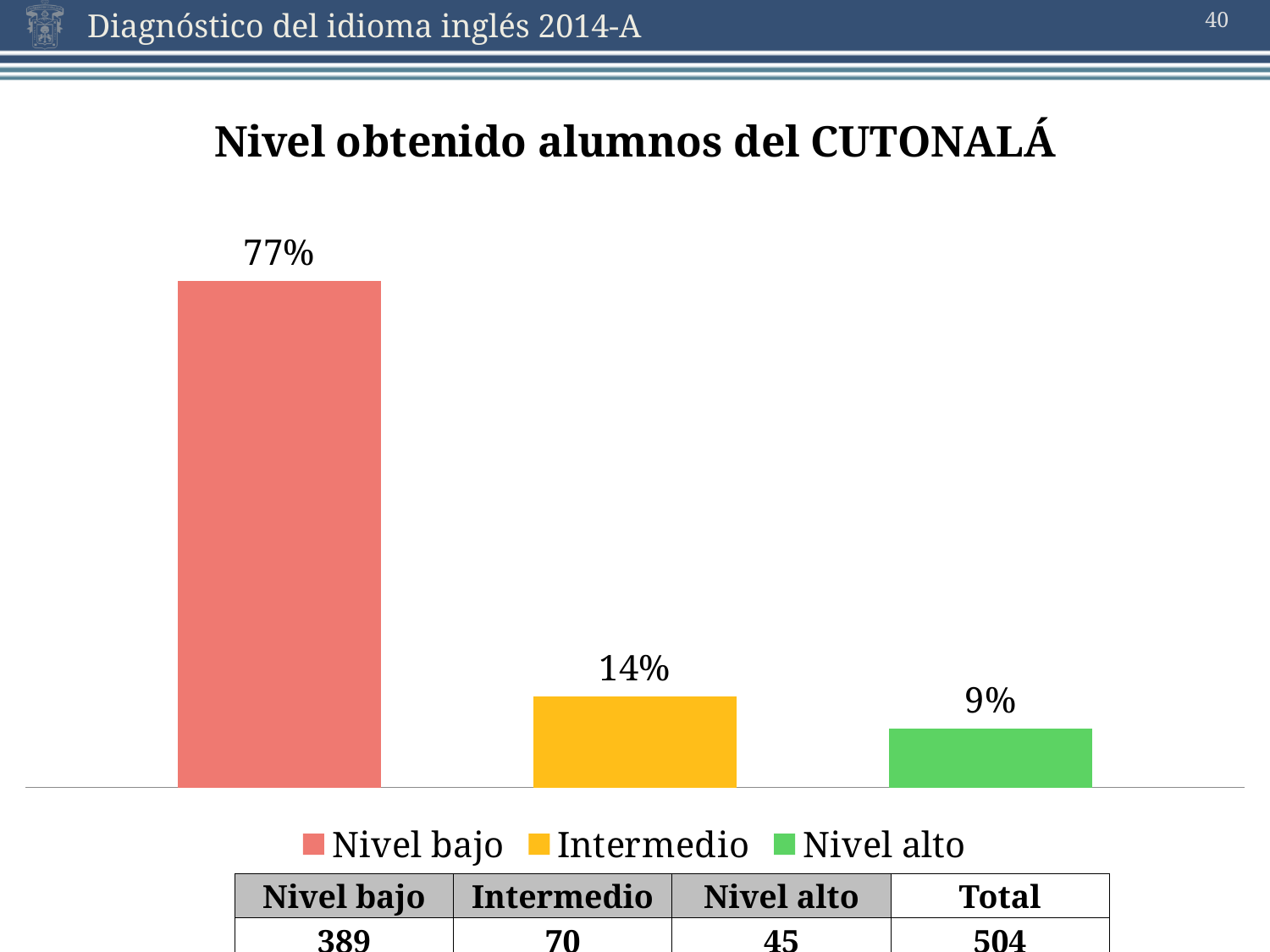
What kind of chart is shown on the slide? Bar chart Which level has the highest percentage? Nivel bajo Which is larger, the percentage for Intermedio or for Nivel alto? Intermedio What is the title of the chart? Nivel obtenido alumnos del CUTONALÁ What is the difference in percentage points between Intermedio and Nivel alto? 5 How many entries does the legend list? 3 What percentage is shown for Intermedio? 14% How many bars are shown in the chart? 3 Which level has the lowest percentage? Nivel alto What percentage is shown for Nivel alto? 9% What is the difference in percentage points between Nivel bajo and Intermedio? 63 What percentage is shown for Nivel bajo? 77%